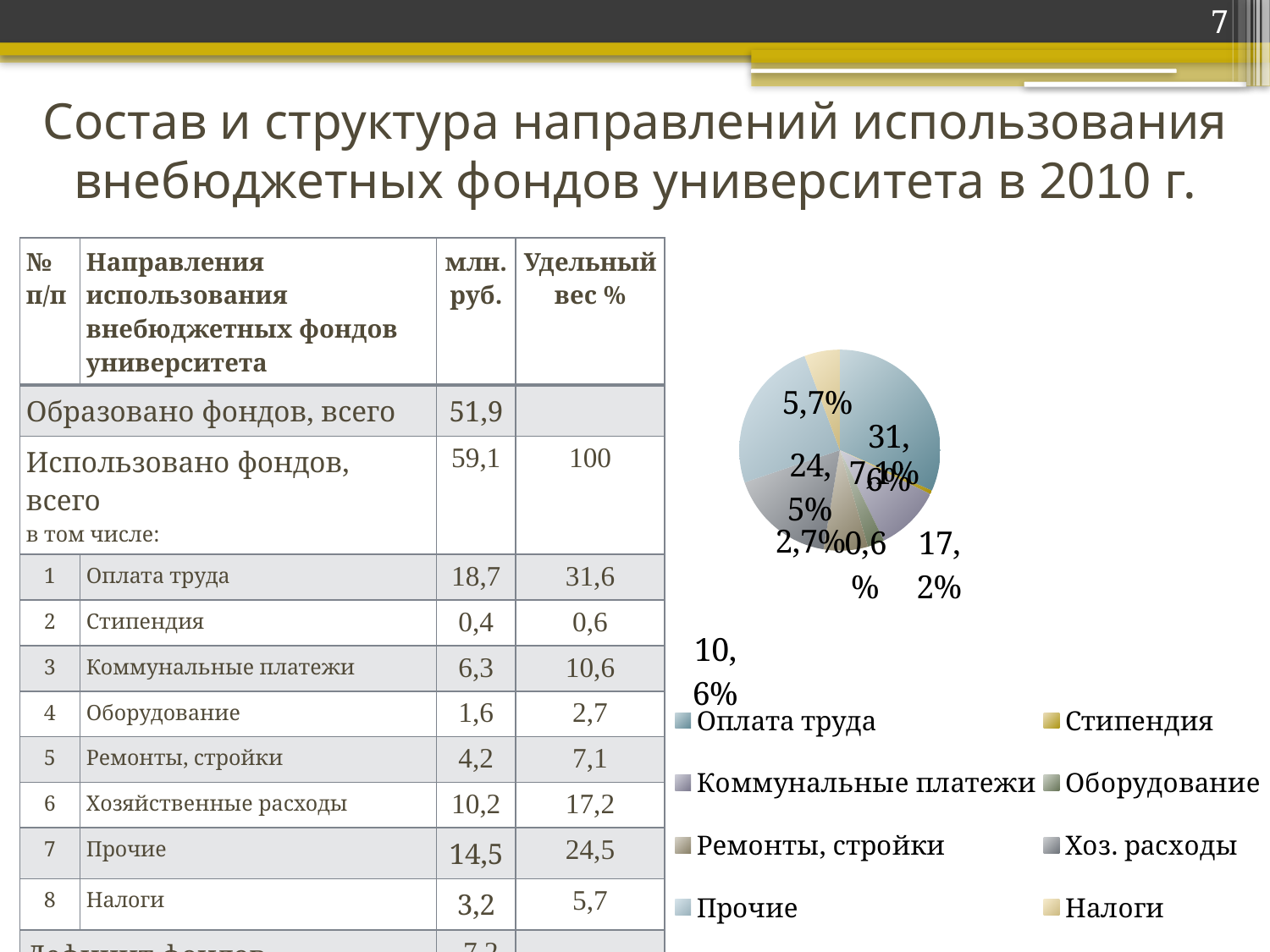
What share of the pie does Прочие take? 24,5% What share of the pie does Хоз. расходы take? 17,2% How many slices does the pie chart have? 8 Which slice is larger, Прочие or Хоз. расходы? Прочие What kind of chart is shown on the slide? pie chart What is the difference in percentage points between the Оплата труда slice and the Прочие slice? 7,1 How many entries does the pie chart's legend list? 8 What share of the pie does Налоги take? 5,7% Which category has the smallest slice of the pie? Стипендия Which category has the largest slice of the pie? Оплата труда